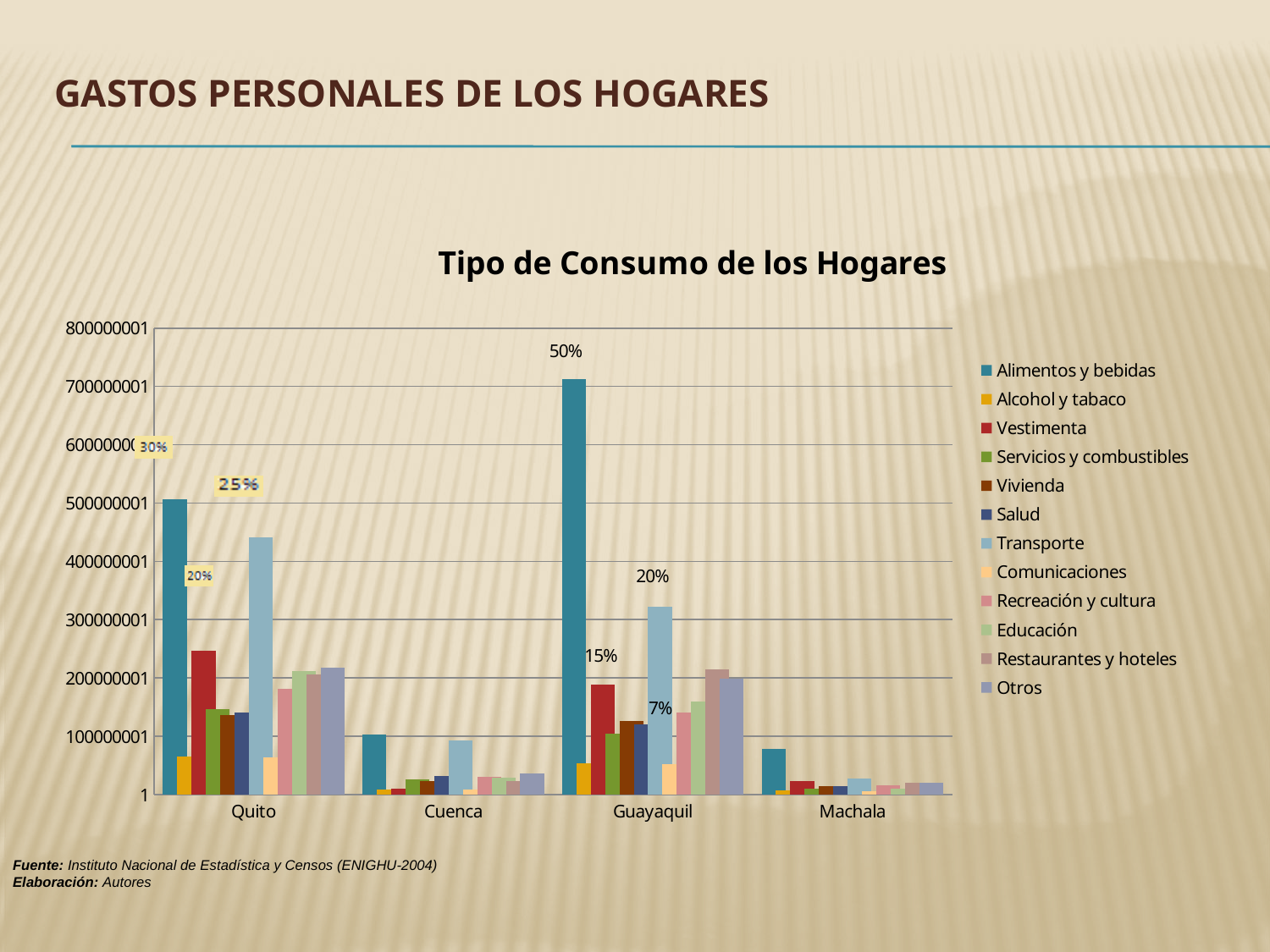
How many cities (categories) are shown on the x axis of the chart? 4 Which city has the lowest value for Alimentos y bebidas? Machala Which series has the tallest bar for Quito? Alimentos y bebidas How many series does the chart's legend list? 12 Is the value for Alimentos y bebidas in Guayaquil greater or less than 600000001? greater Is the value for Alimentos y bebidas in Quito greater or less than 600000001? less Which is larger, the Transporte value for Quito or for Cuenca? Quito Which city has the highest value for Alimentos y bebidas? Guayaquil What is the title of the chart? Tipo de Consumo de los Hogares What kind of chart is shown on the slide? bar chart Which series is listed first in the chart's legend? Alimentos y bebidas Which is larger, the Vestimenta value for Quito or for Guayaquil? Quito